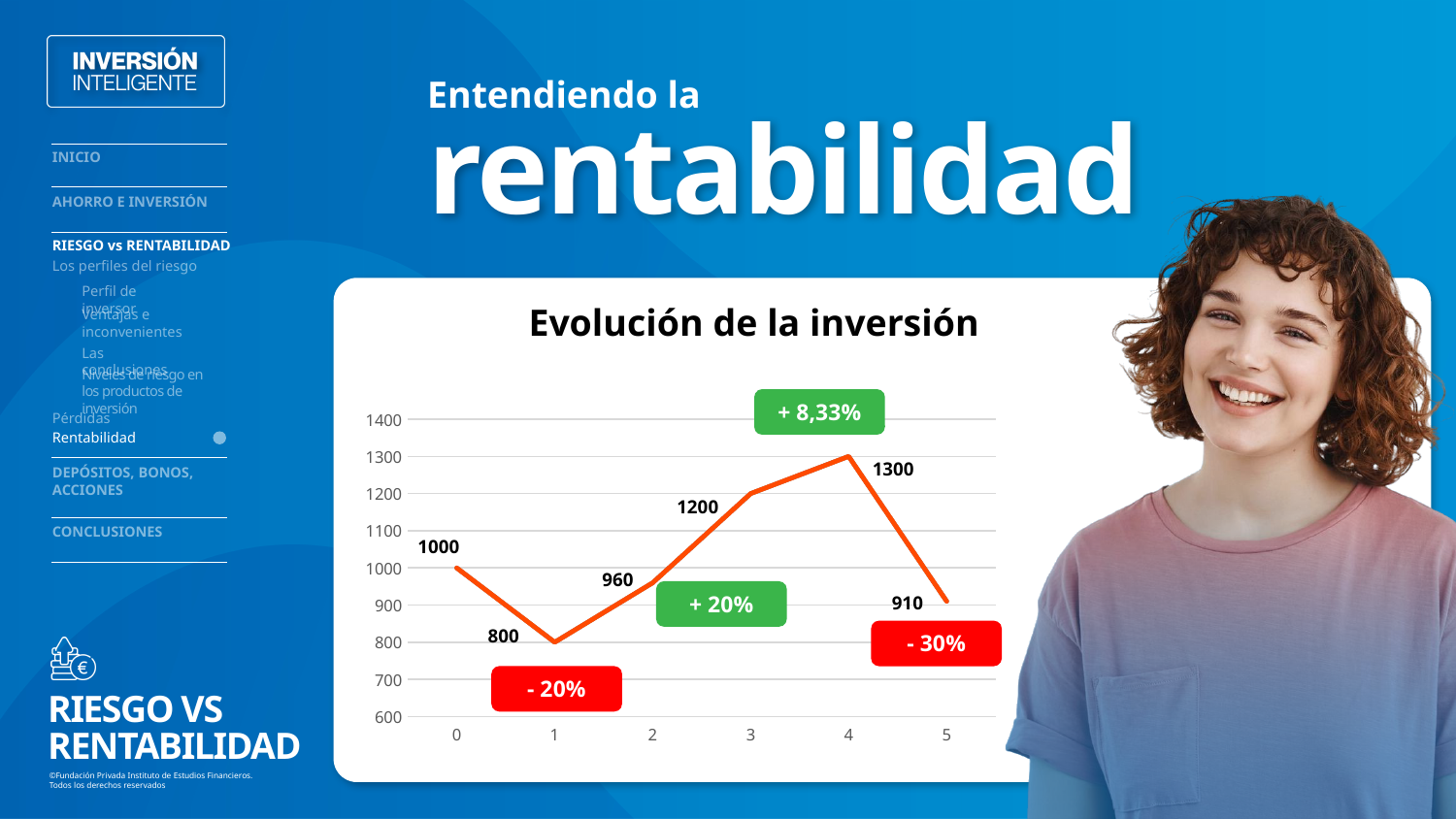
How many data points are plotted on the line? 6 What is the value at x = 2? 960 What is the difference between the value at x = 4 and the value at x = 3? 100 What percentage change is labelled between x = 4 and x = 5? - 30% Which is larger, the value at x = 2 or the value at x = 5? x = 2 At which x value is the investment highest? 4 What is the value at x = 0? 1000 What is the title of the chart? Evolución de la inversión What is the value at x = 5? 910 What kind of chart is shown on the slide? line chart What is the value at x = 1? 800 At which x value is the investment lowest? 1